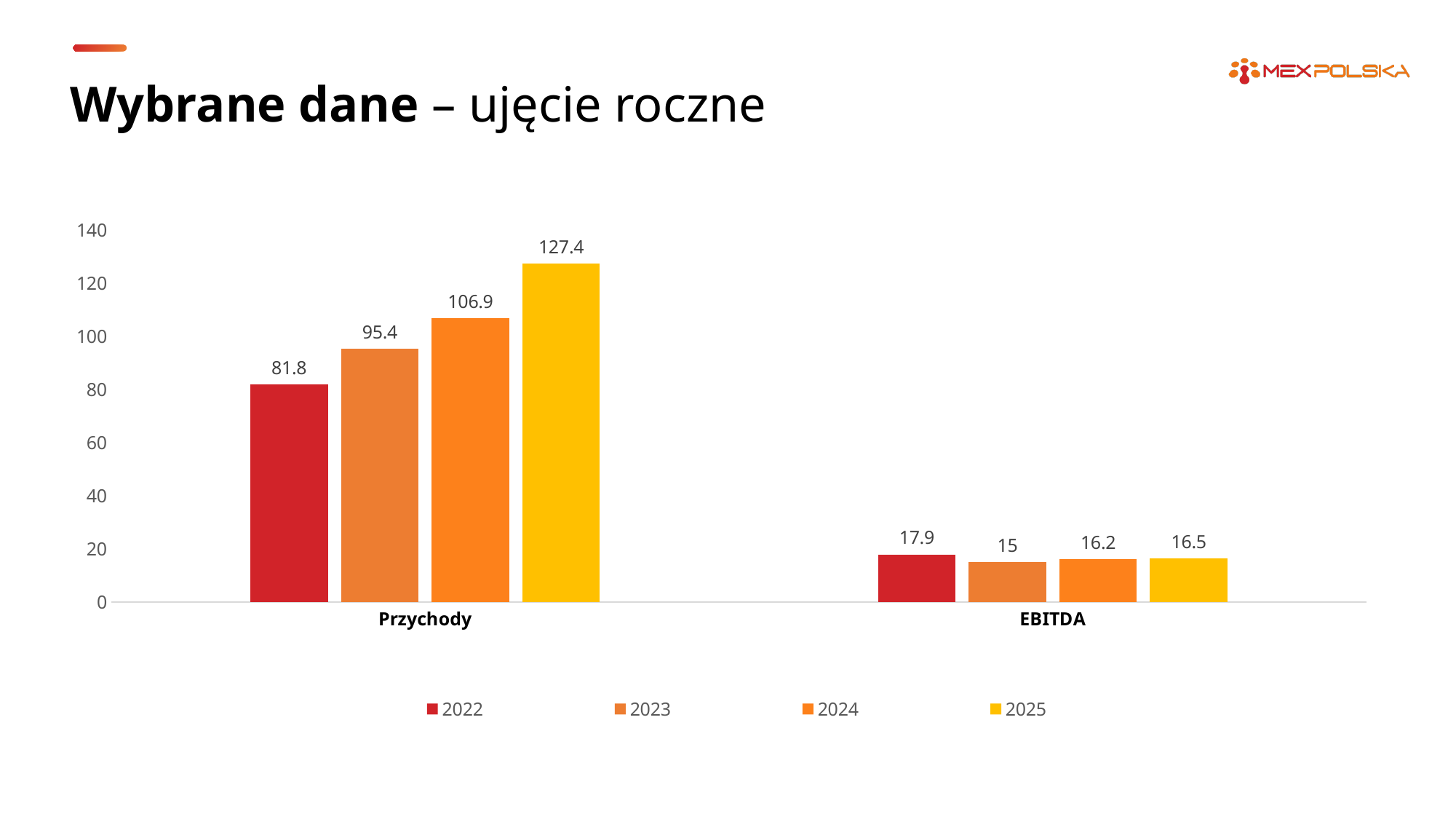
What is the Przychody value for 2022? 81.8 How many series does the legend list? 4 Is the Przychody value for 2024 greater or less than 100? greater Do the Przychody values rise or fall from 2022 to 2025? rise How many categories are shown on the x axis? 2 Which year has the highest Przychody value? 2025 What is the EBITDA value for 2023? 15 Which is larger, the EBITDA value for 2022 or for 2025? 2022 What is the Przychody value for 2025? 127.4 What is the difference between the Przychody values for 2025 and 2022? 45.6 What kind of chart is shown on the slide? bar chart Which year has the lowest EBITDA value? 2023